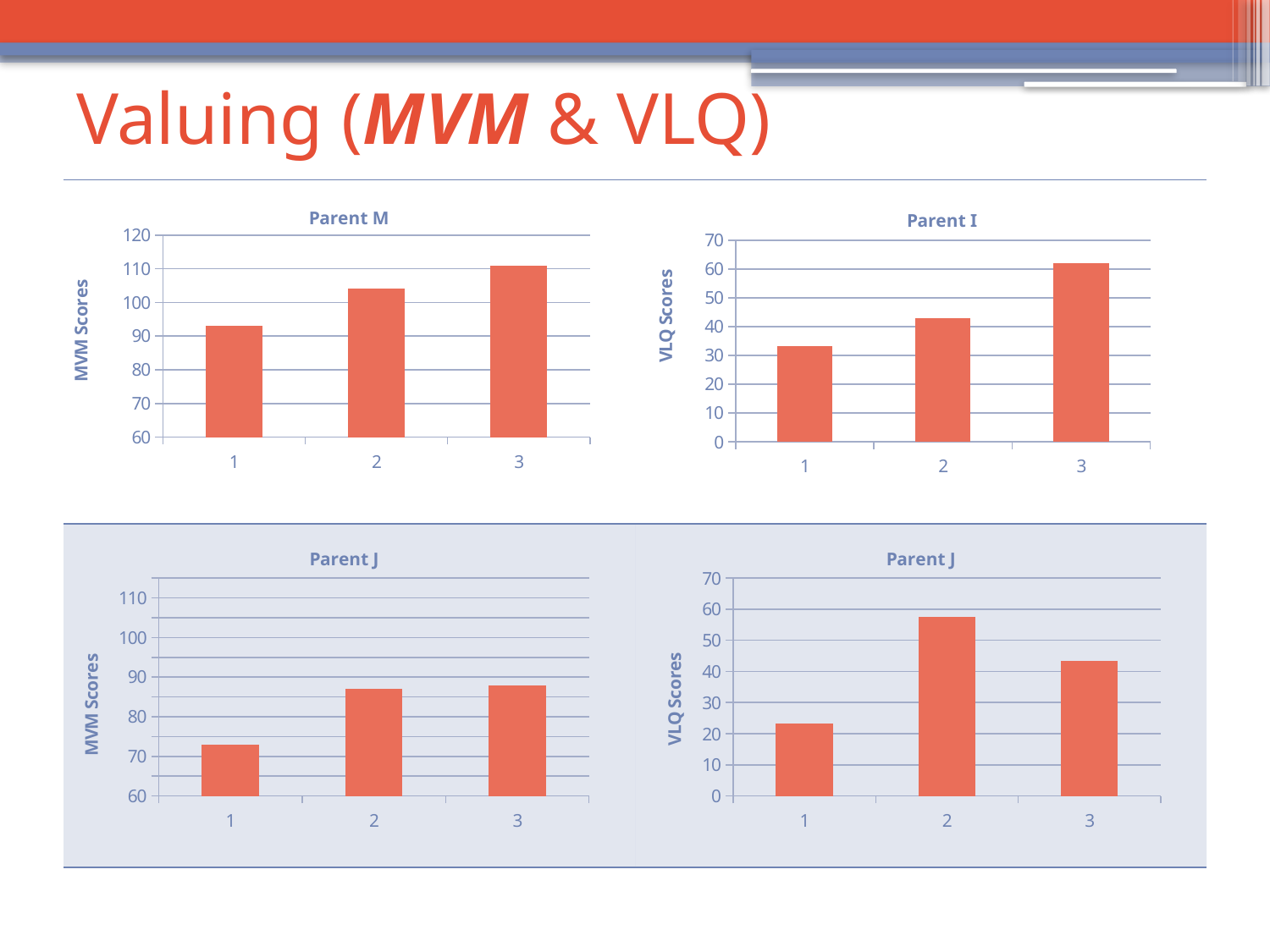
In the Parent I chart, do the values rise or fall from category 1 to category 3? rise In the Parent J chart with MVM Scores (bottom left), is the value for category 1 greater or less than 80? less In the Parent J chart with MVM Scores (bottom left), which category has the lowest bar? 1 How many bars are in the Parent I chart? 3 In the Parent J chart with VLQ Scores (bottom right), which is larger, the value for category 2 or category 3? category 2 In the Parent J chart with VLQ Scores (bottom right), which category has the highest bar? 2 What type of chart is the Parent M chart? bar chart In the Parent I chart, which category has the lowest bar? 1 In the Parent I chart, is the value for category 3 greater or less than 60? greater In the Parent M chart, is the value for category 1 greater or less than 100? less In the Parent M chart, which category has the highest bar? 3